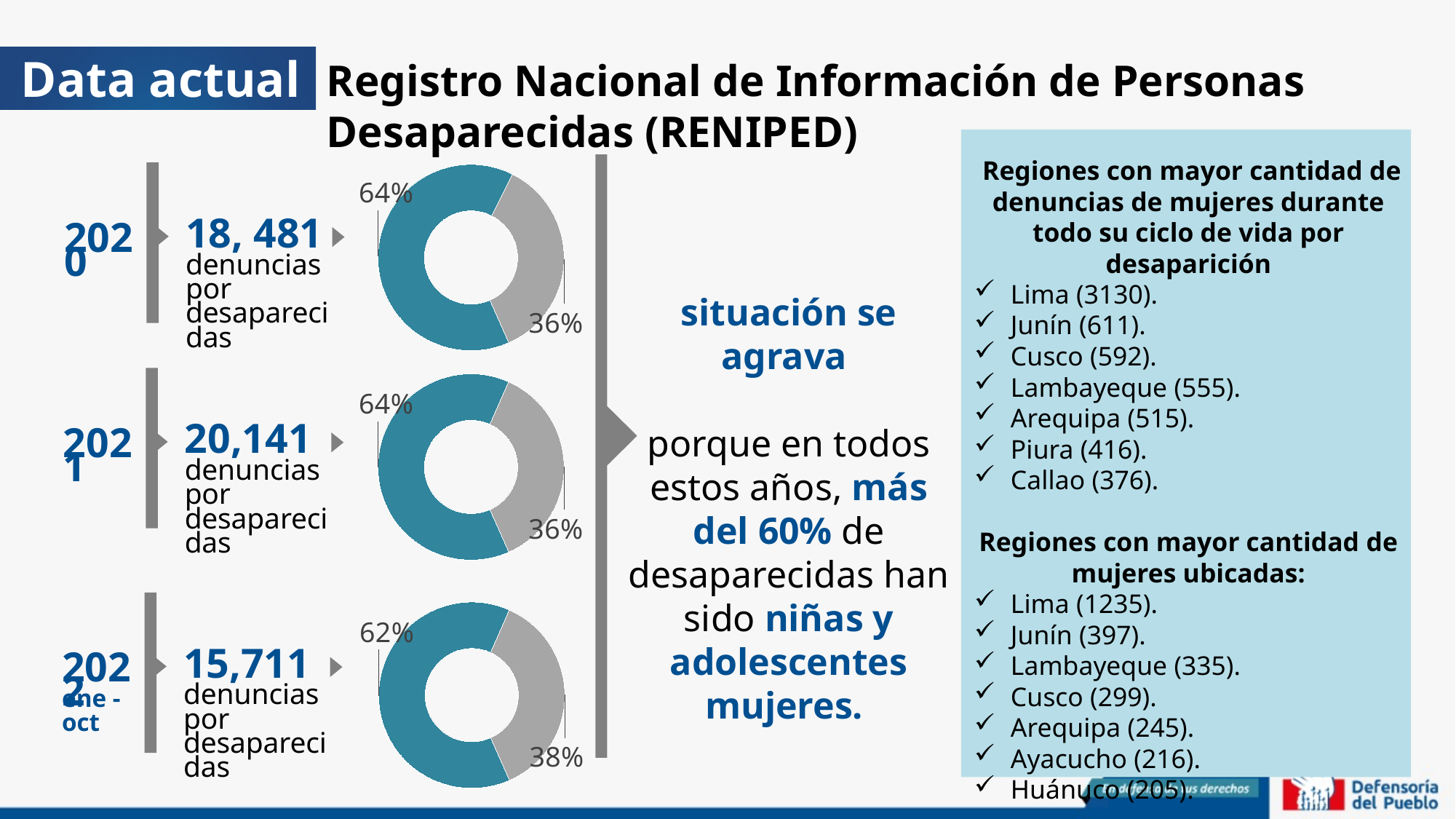
In the 2021 donut chart, what is the difference in percentage points between the teal slice and the gray slice? 28 In the 2021 donut chart, what percentage is shown for the teal slice? 64% In the 2022 (ene - oct) donut chart, what percentage is shown for the gray slice? 38% How many slices does each donut chart on the slide have? 2 In the 2022 (ene - oct) donut chart, what percentage is shown for the teal slice? 62% In the 2020 donut chart, what percentage is shown for the gray slice? 36% How many donut charts are shown on the slide? 3 What is the total number of denuncias por desaparecidas shown next to the 2021 donut chart? 20,141 What type of chart is used for the 2020 data on the slide? Donut chart In the 2020 donut chart, what percentage is shown for the teal slice? 64% Which year's donut chart shows the smallest teal slice? 2022 (ene - oct) In the 2022 (ene - oct) donut chart, which slice is larger, the teal one or the gray one? The teal one